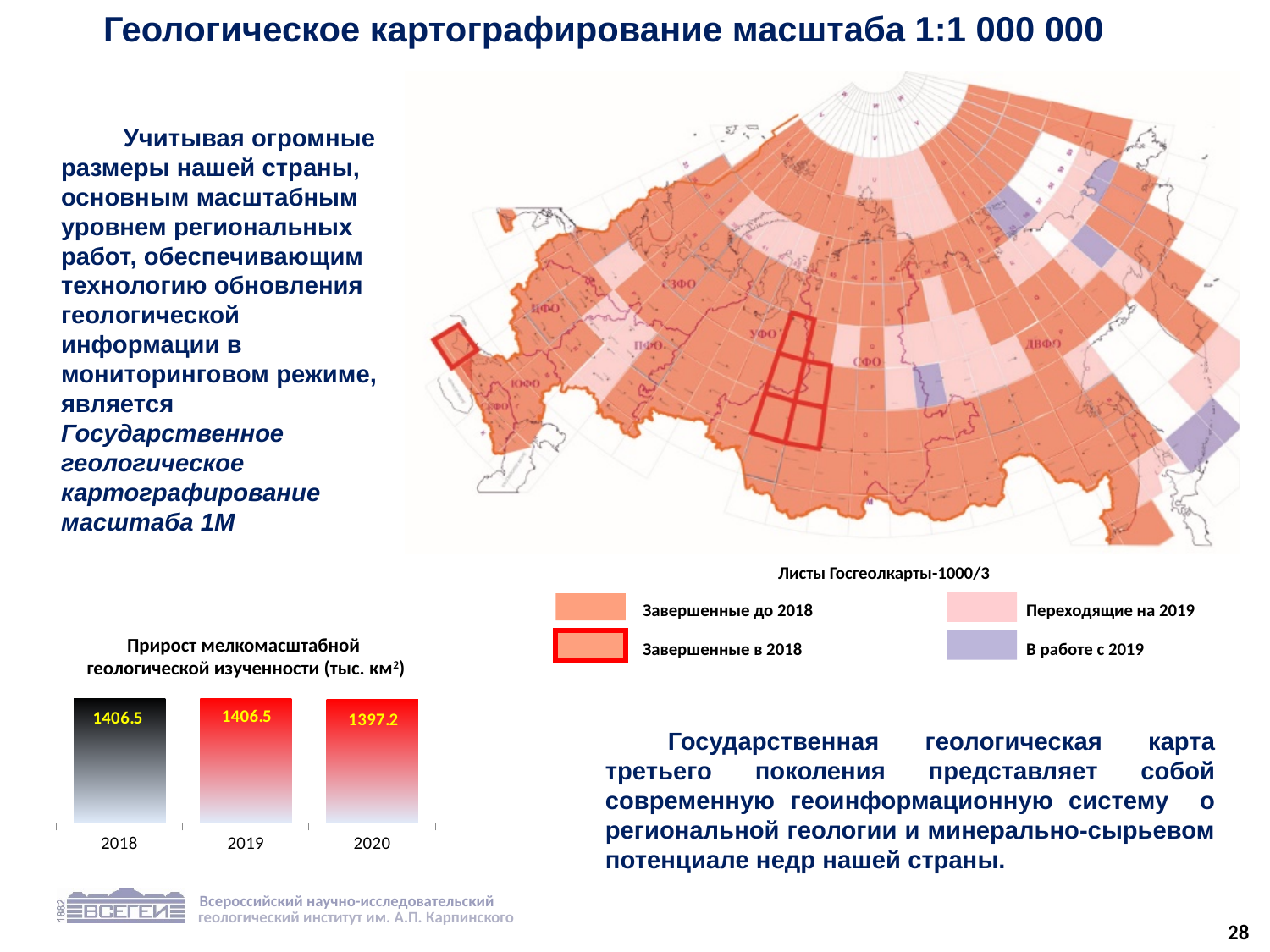
What unit is given in the title of the bar chart at the bottom left of the slide? тыс. км² How many years (categories) are shown in the bar chart 'Прирост мелкомасштабной геологической изученности'? 3 What kind of chart is 'Прирост мелкомасштабной геологической изученности (тыс. км²)'? bar chart In the bar chart 'Прирост мелкомасштабной геологической изученности', which year's bar is coloured black at the top rather than red? 2018 In the bar chart 'Прирост мелкомасштабной геологической изученности', which year has the lowest value? 2020 What is the value for 2019 in the bar chart 'Прирост мелкомасштабной геологической изученности (тыс. км²)'? 1406.5 In the bar chart 'Прирост мелкомасштабной геологической изученности', is the value for 2018 larger than, smaller than, or equal to the value for 2019? equal In the bar chart 'Прирост мелкомасштабной геологической изученности', what is the difference between the 2019 value and the 2020 value? 9.3 What is the value for 2020 in the bar chart 'Прирост мелкомасштабной геологической изученности (тыс. км²)'? 1397.2 In the bar chart 'Прирост мелкомасштабной геологической изученности', is the value for 2020 larger or smaller than the value for 2018? smaller In the bar chart 'Прирост мелкомасштабной геологической изученности', do the values rise or fall from 2019 to 2020? fall What is the value for 2018 in the bar chart 'Прирост мелкомасштабной геологической изученности (тыс. км²)'? 1406.5